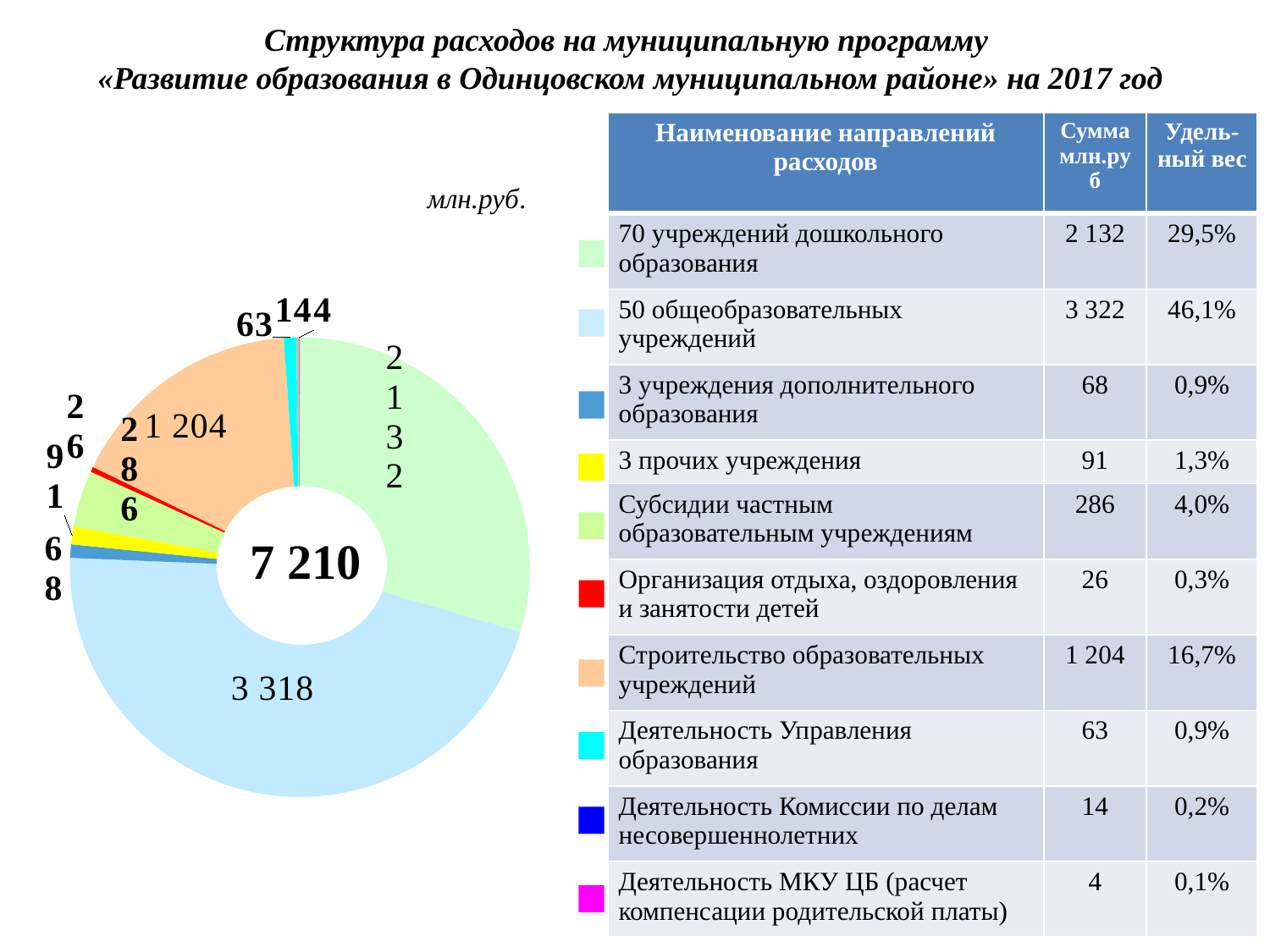
What total value is printed in the centre of the doughnut chart? 7 210 Which is larger on the chart: 70 учреждений дошкольного образования or Строительство образовательных учреждений? 70 учреждений дошкольного образования What share of the total do the 50 общеобразовательных учреждений account for, according to the slide? 46,1% Which category has the largest slice in the doughnut chart? 50 общеобразовательных учреждений In what units are the chart values given? млн.руб. What value is labelled on the chart for Строительство образовательных учреждений? 1 204 How many categories (slices) does the doughnut chart have? 10 What is the difference between the chart values for Строительство образовательных учреждений (1 204) and Субсидии частным образовательным учреждениям (286)? 918 What value is labelled on the chart for Субсидии частным образовательным учреждениям? 286 Which category has the smallest slice in the doughnut chart? Деятельность МКУ ЦБ (расчет компенсации родительской платы) What value is labelled on the chart for Деятельность Управления образования? 63 What kind of chart is shown on the slide? doughnut chart